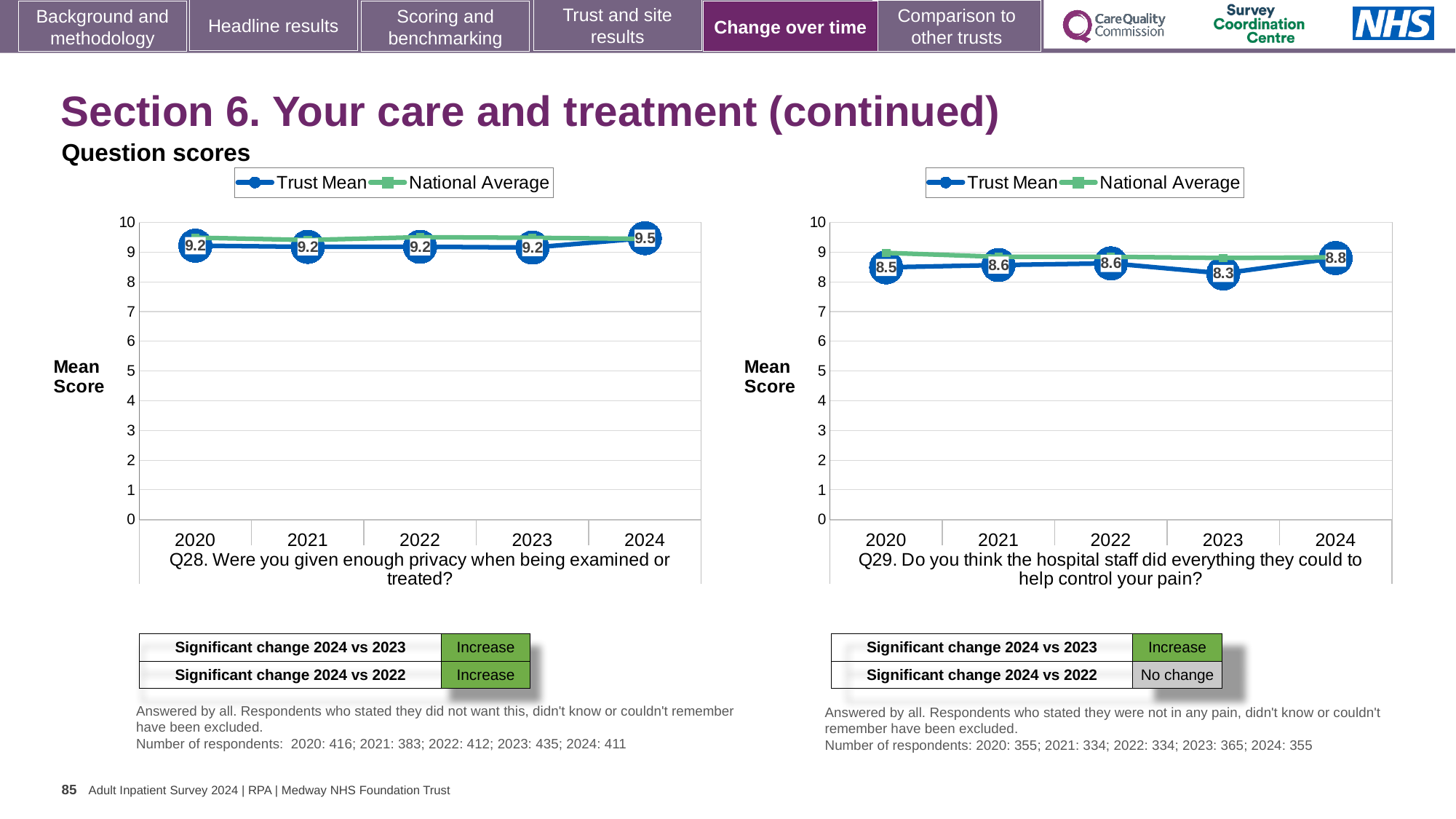
In the Q28 chart (left), what is the difference between the Trust Mean scores for 2024 and 2023? 0.3 What kind of chart is the Q28 chart (left)? Line chart In the Q29 chart (right), what is the Trust Mean score for 2024? 8.8 In the Q29 chart (right), what is the Trust Mean score for 2023? 8.3 How many years are plotted on the x axis of the Q28 chart (left)? 5 In the Q29 chart (right), which year has the lowest Trust Mean score? 2023 How many series does the legend of the Q29 chart (right) list? 2 In the Q28 chart (left), which year has the highest Trust Mean score? 2024 In the Q28 chart (left), what is the Trust Mean score for 2024? 9.5 In the Q29 chart (right), is the Trust Mean score for 2020 greater or less than 9? less In the Q28 chart (left), what is the Trust Mean score for 2021? 9.2 In the Q29 chart (right), what is the difference between the Trust Mean scores for 2024 and 2023? 0.5